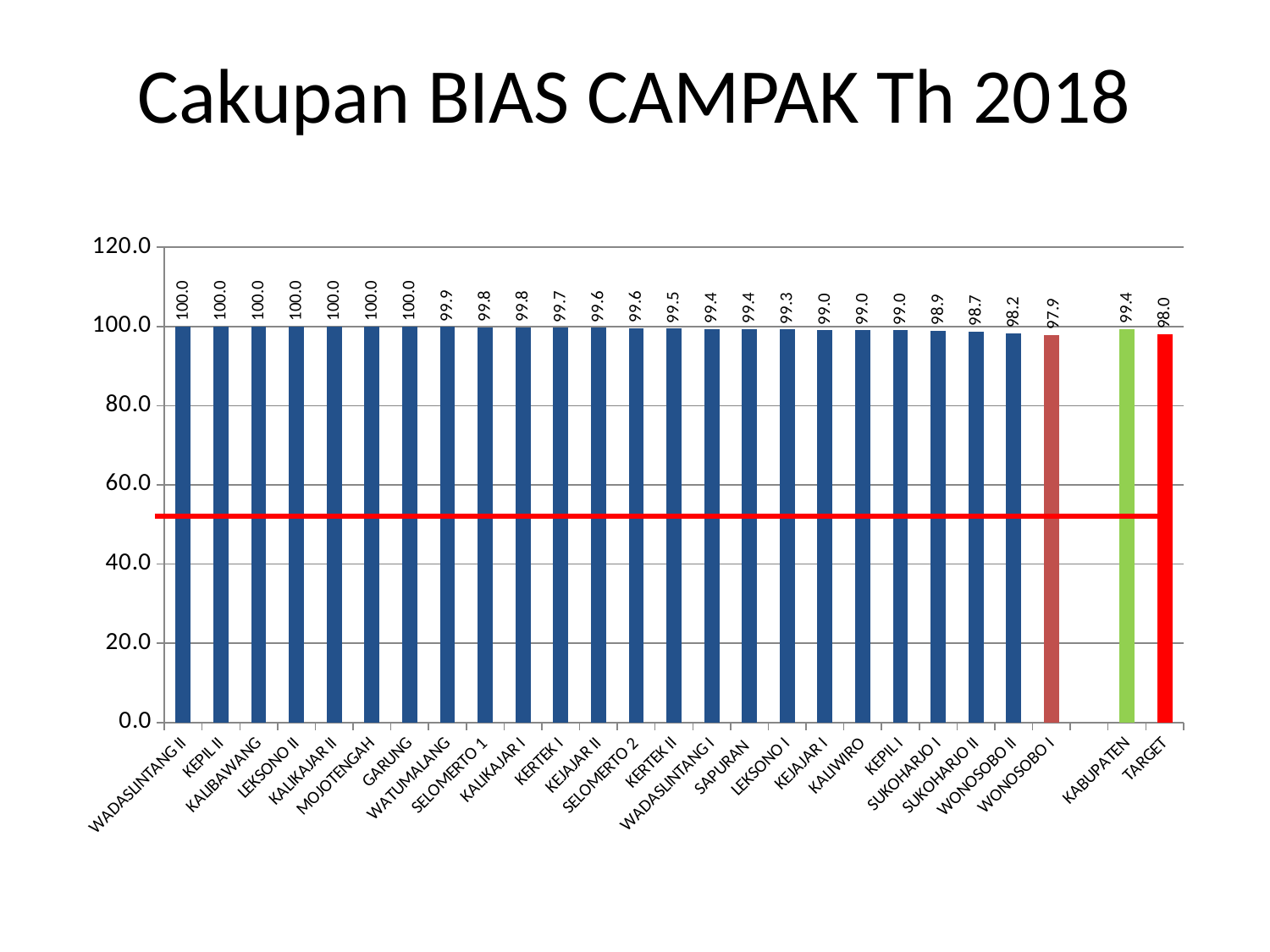
What is the value for WONOSOBO I? 97.9 What is the difference between the values for WADASLINTANG II and WONOSOBO I? 2.1 What is the title of the chart? Cakupan BIAS CAMPAK Th 2018 Is the value for WONOSOBO II greater or less than 80.0? greater What is the value for KABUPATEN? 99.4 How many bars are shown in the chart? 26 What is the value for SUKOHARJO II? 98.7 What is the difference between the KABUPATEN value and the TARGET value? 1.4 Which is larger, the value for KABUPATEN or the value for TARGET? KABUPATEN What kind of chart is shown on the slide? bar chart What is the value for TARGET? 98.0 Which category has the lowest value? WONOSOBO I